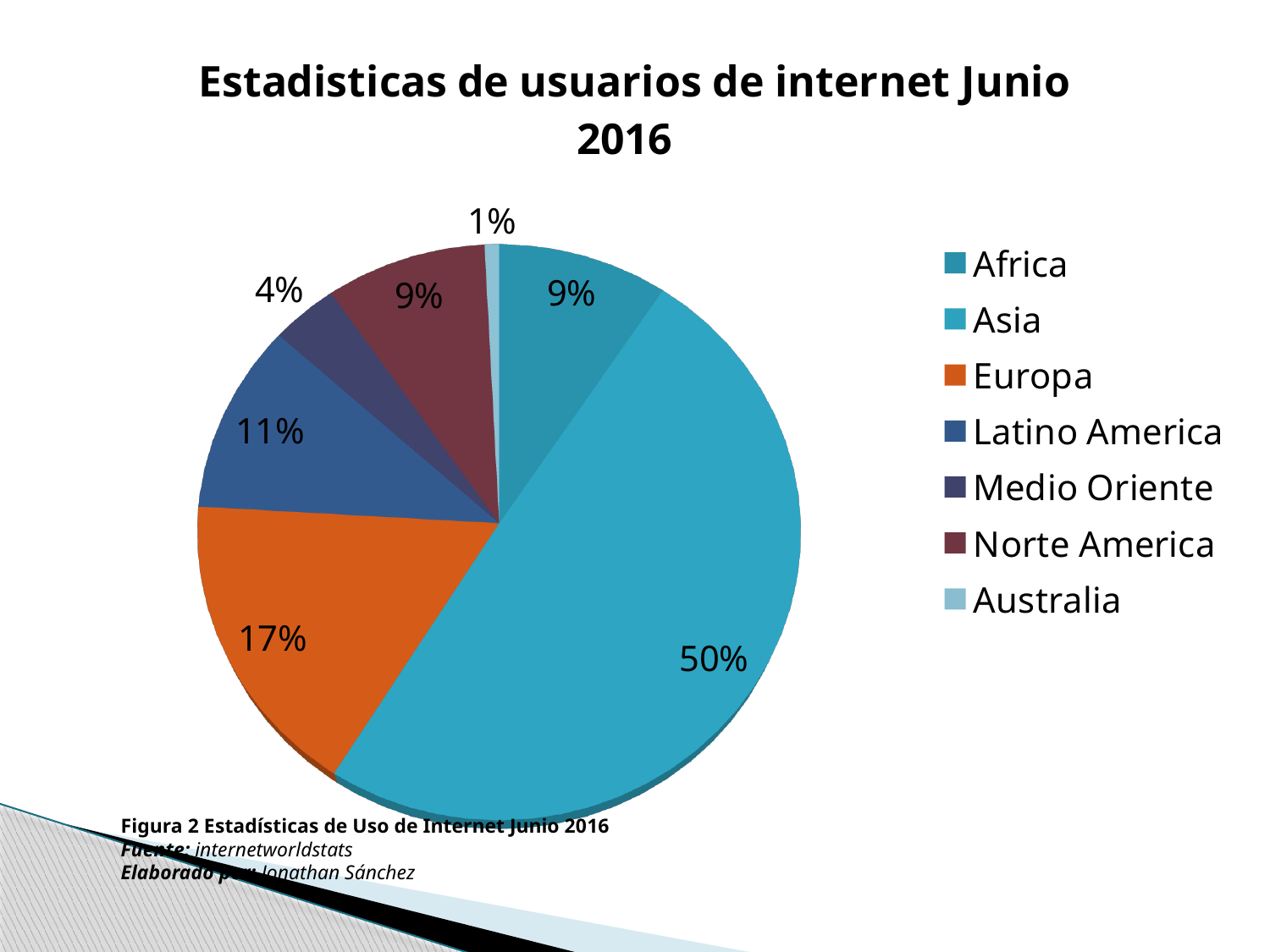
Which region has the smallest slice of the pie? Australia What share of the pie does Latino America hold? 11% What share of the pie does Asia hold? 50% What kind of chart is shown on the slide? Pie chart What is the difference in percentage points between Asia and Europa? 33 What share of the pie does Europa hold? 17% How many regions are shown in the pie chart? 7 Which region has the largest slice of the pie? Asia What is the title of the chart? Estadisticas de usuarios de internet Junio 2016 Which is larger, the share for Europa or the share for Latino America? Europa